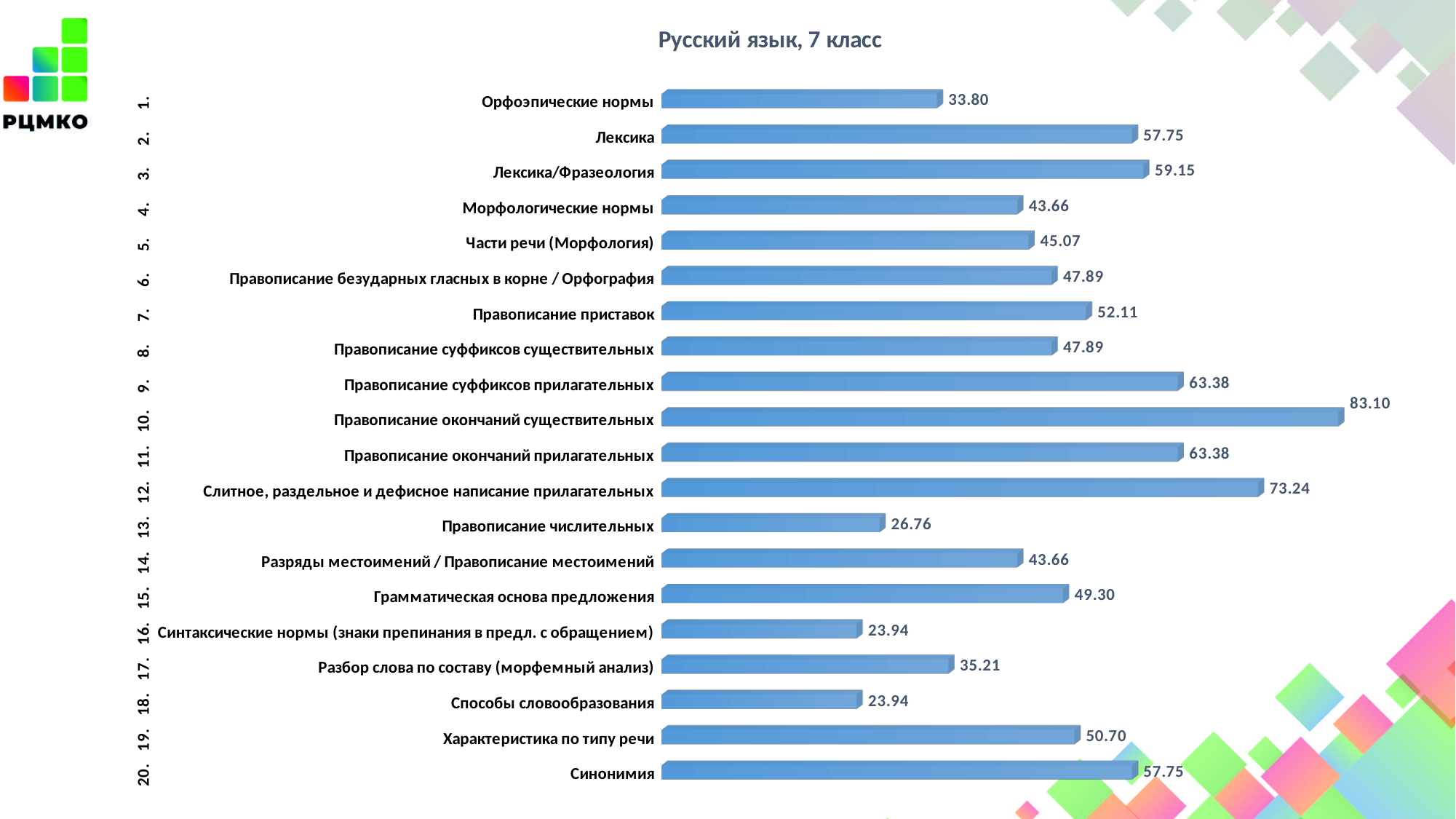
What is the title of the chart? Русский язык, 7 класс What is the value for Правописание окончаний существительных? 83.10 What is the value for Правописание числительных? 26.76 What is the lowest value shown in the chart? 23.94 How many categories are plotted in the chart? 20 What is the difference between the values for Правописание приставок and Правописание суффиксов существительных? 4.22 Which category has the highest value? Правописание окончаний существительных What is the value for Синонимия? 57.75 What type of chart is shown on the slide? bar chart Which is larger: the value for Лексика/Фразеология or the value for Морфологические нормы? Лексика/Фразеология What is the value for Характеристика по типу речи? 50.70 What is the difference between the values for Правописание окончаний существительных and Слитное, раздельное и дефисное написание прилагательных? 9.86